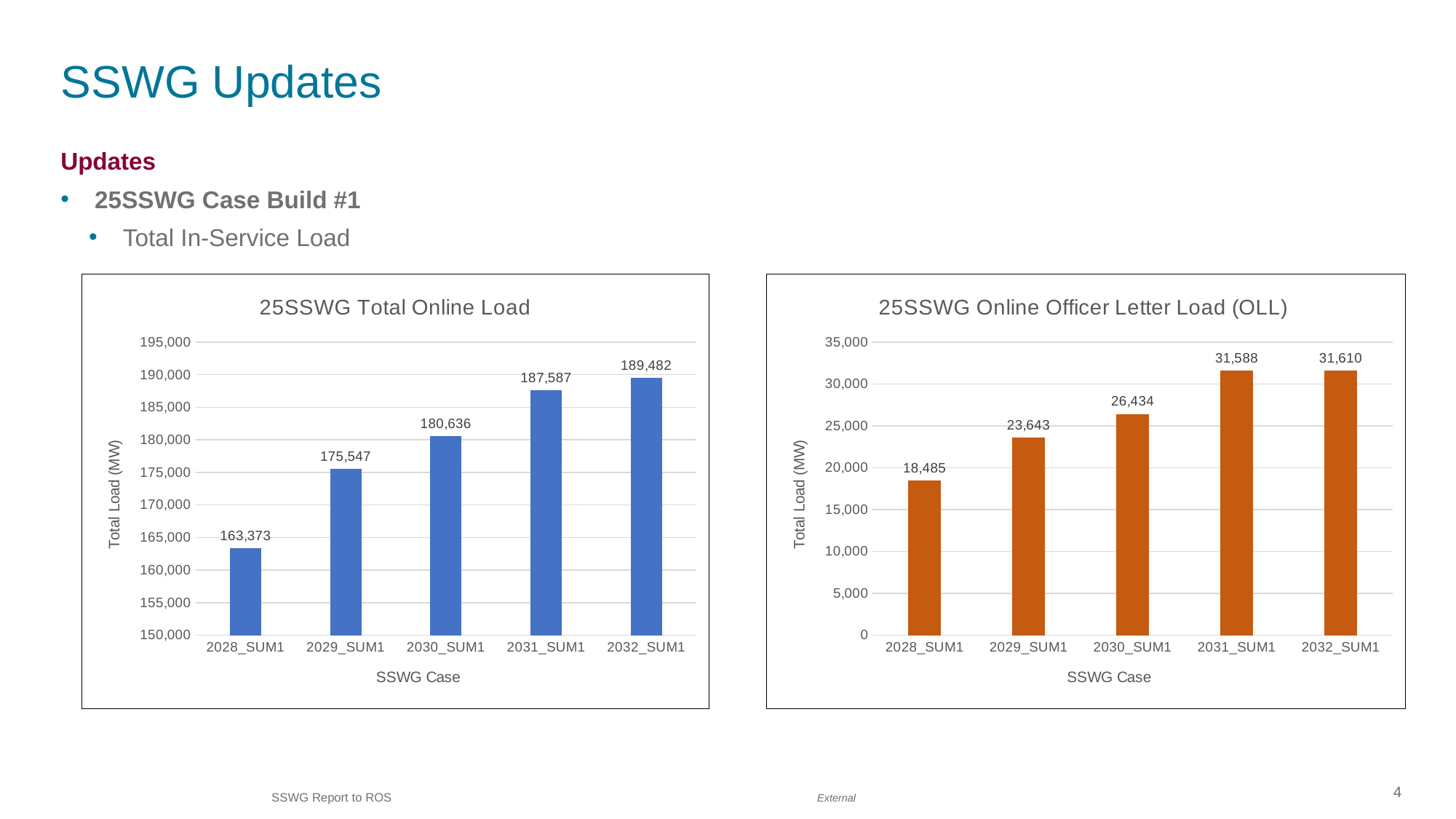
In the 25SSWG Total Online Load chart, what is the difference between the values for 2032_SUM1 and 2028_SUM1? 26,109 How many SSWG cases are shown in the 25SSWG Total Online Load chart? 5 In the 25SSWG Online Officer Letter Load (OLL) chart, which SSWG case has the lowest value? 2028_SUM1 In the 25SSWG Total Online Load chart, which is larger, the value for 2029_SUM1 or the value for 2031_SUM1? 2031_SUM1 In the 25SSWG Online Officer Letter Load (OLL) chart, what is the value for 2029_SUM1? 23,643 In the 25SSWG Online Officer Letter Load (OLL) chart, is the value for 2030_SUM1 greater or less than 25,000? greater In the 25SSWG Total Online Load chart, do the values rise or fall from 2028_SUM1 to 2032_SUM1? rise In the 25SSWG Total Online Load chart, which SSWG case has the highest total load? 2032_SUM1 What is the y-axis label of the 25SSWG Online Officer Letter Load (OLL) chart? Total Load (MW) In the 25SSWG Total Online Load chart, what is the value for 2030_SUM1? 180,636 What kind of chart is the 25SSWG Online Officer Letter Load (OLL) chart? bar chart In the 25SSWG Online Officer Letter Load (OLL) chart, what is the difference between the values for 2030_SUM1 and 2028_SUM1? 7,949